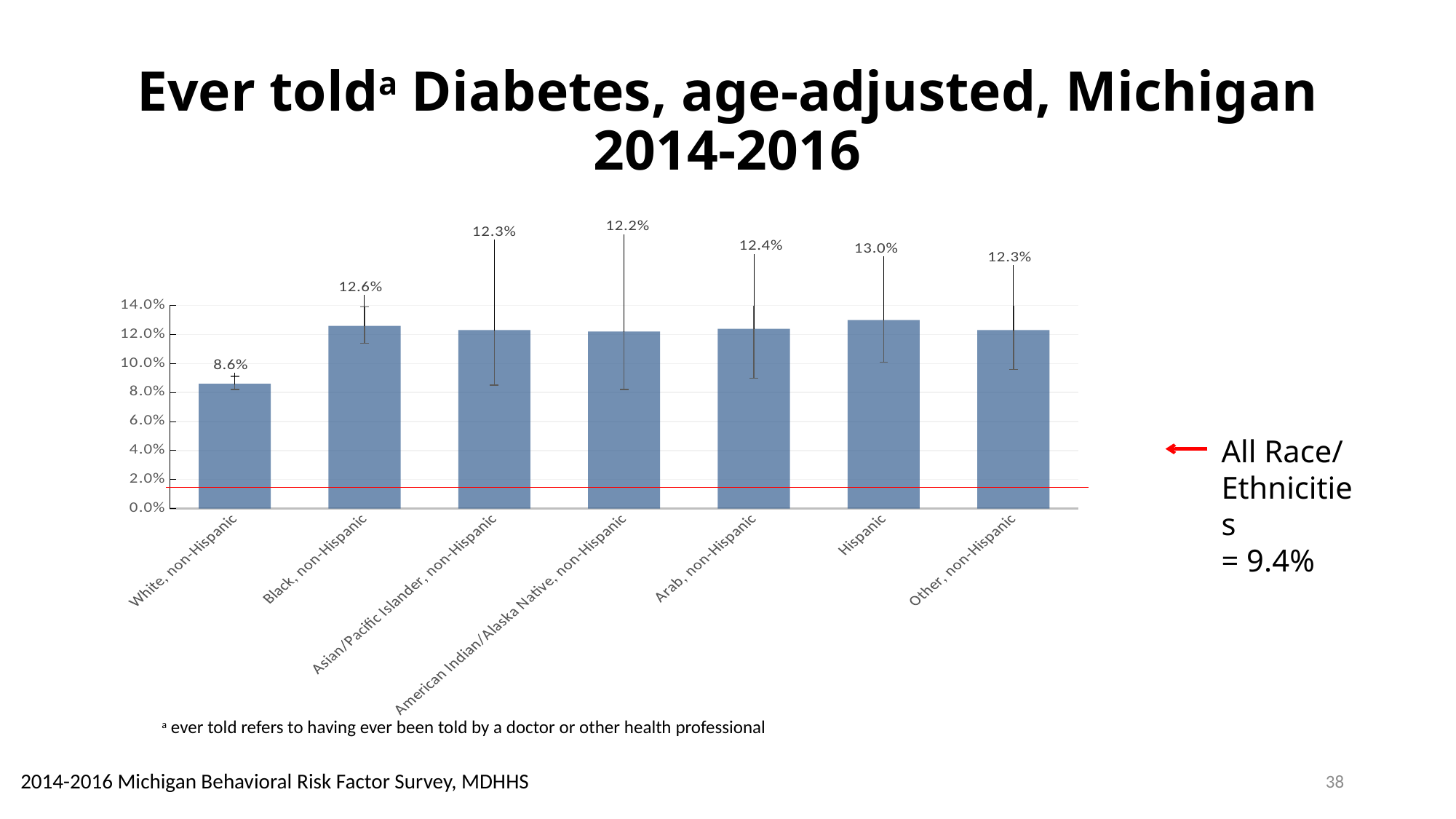
What is the value for American Indian/Alaska Native, non-Hispanic? 12.2% Which is larger, the value for Arab, non-Hispanic or the value for White, non-Hispanic? Arab, non-Hispanic Which category has the highest value? Hispanic What is the value for White, non-Hispanic? 8.6% What is the value for Black, non-Hispanic? 12.6% What kind of chart is shown on the slide? bar chart Is the value for White, non-Hispanic greater or less than 10.0%? less Which category has the lowest value? White, non-Hispanic According to the text beside the chart, what is the value for All Race/Ethnicities? 9.4% What is the difference between the values for Hispanic and White, non-Hispanic? 4.4% How many categories are shown on the x axis? 7 What is the value for Hispanic? 13.0%